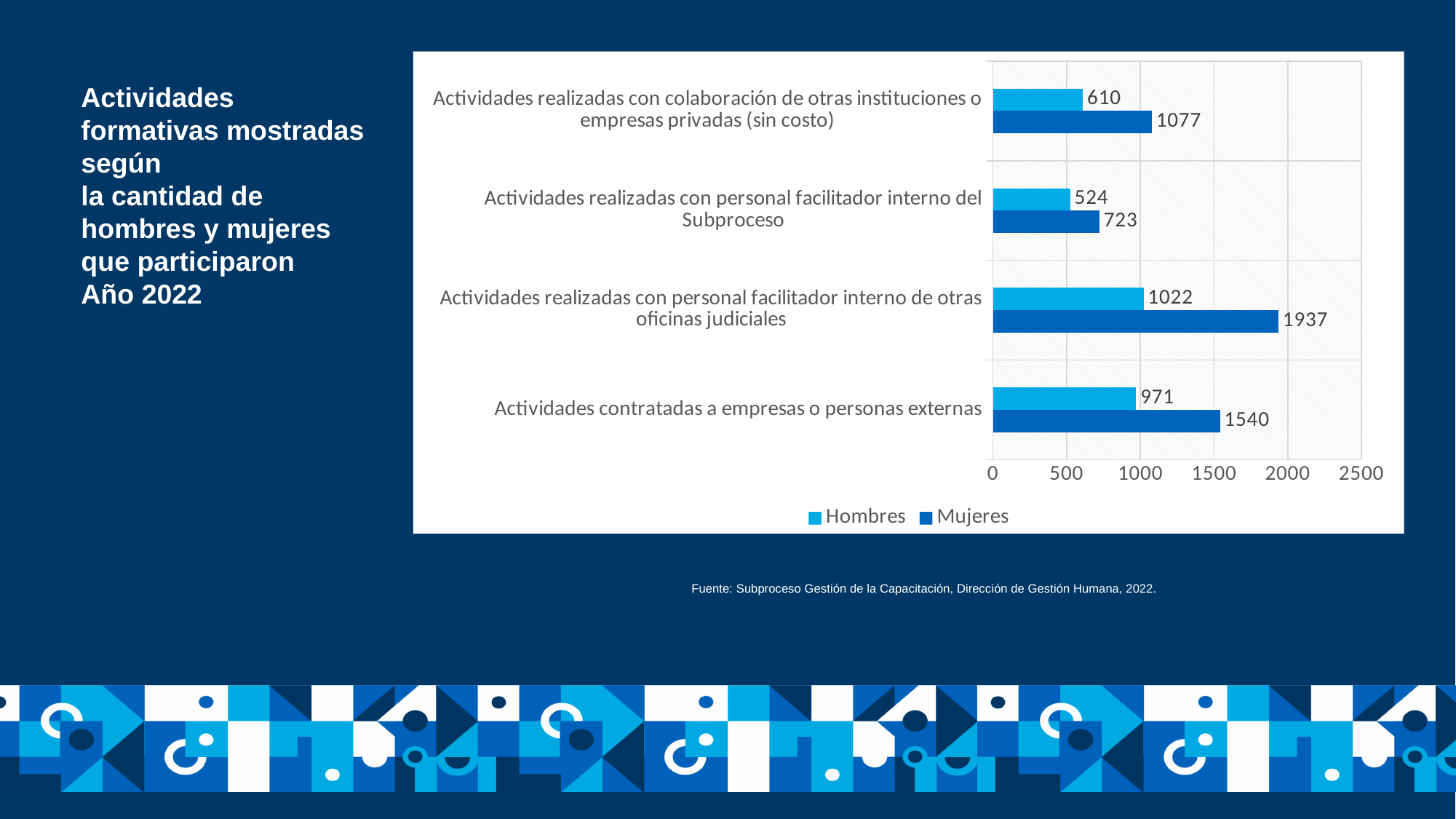
Which category has the highest value for Mujeres? Actividades realizadas con personal facilitador interno de otras oficinas judiciales What kind of chart is shown on the slide? Bar chart What are the two series named in the legend? Hombres and Mujeres What is the value for Hombres in 'Actividades realizadas con personal facilitador interno del Subproceso'? 524 Is the value for Mujeres in 'Actividades realizadas con personal facilitador interno del Subproceso' greater or less than 1000? less What is the value for Hombres in 'Actividades contratadas a empresas o personas externas'? 971 Which category has the lowest value for Hombres? Actividades realizadas con personal facilitador interno del Subproceso What is the value for Mujeres in 'Actividades realizadas con personal facilitador interno de otras oficinas judiciales'? 1937 How many series does the legend list? 2 Which is larger in 'Actividades realizadas con colaboración de otras instituciones o empresas privadas (sin costo)': Hombres or Mujeres? Mujeres How many categories are shown on the chart? 4 What is the difference between Mujeres and Hombres in 'Actividades contratadas a empresas o personas externas'? 569